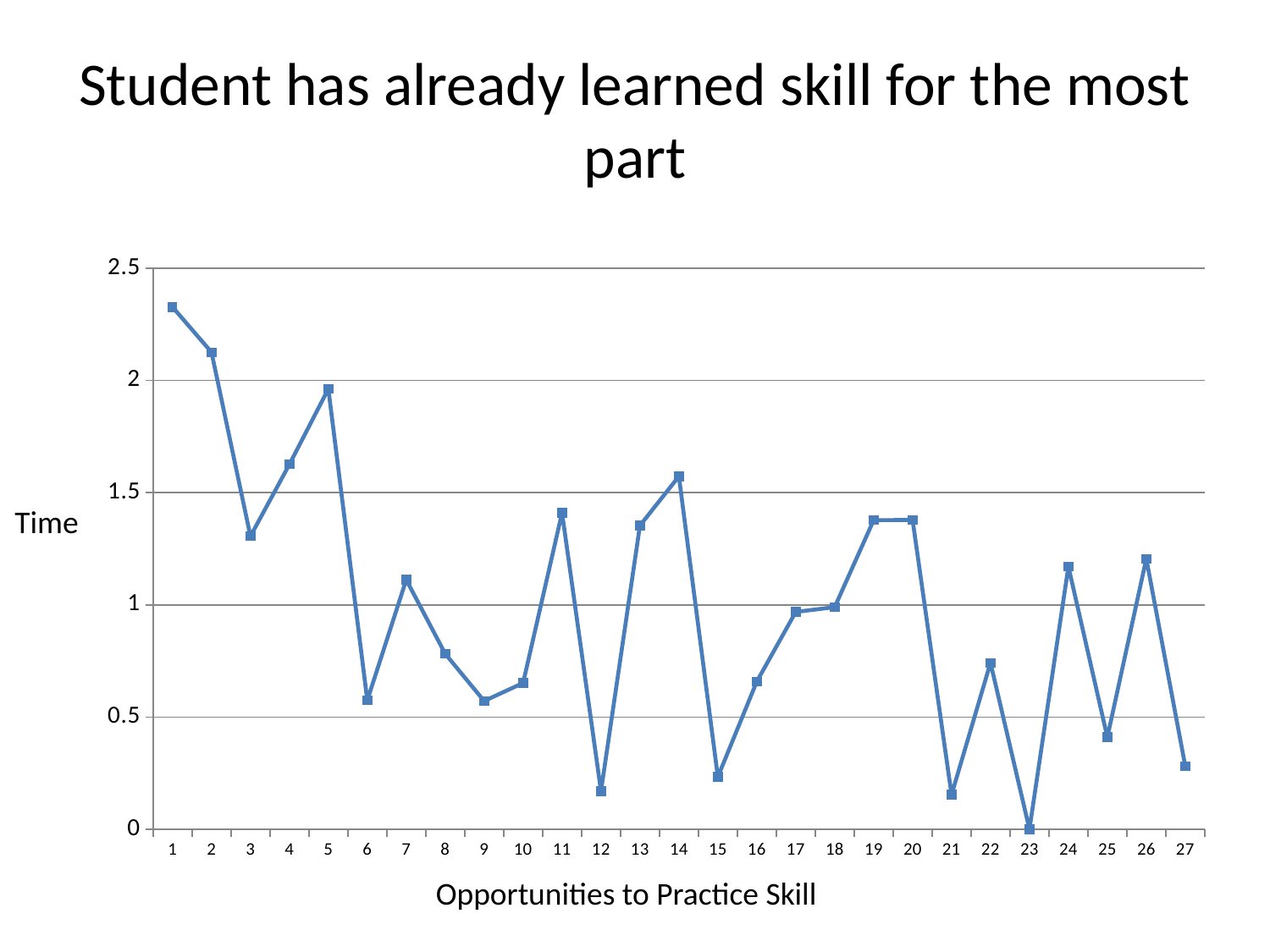
At which opportunity is the time lowest? 23 Is the time at opportunity 12 greater or less than 0.5? less Overall, does the time rise or fall as the number of opportunities to practice the skill increases? fall Is the time at opportunity 1 greater or less than 2? greater How many opportunities (points) are plotted along the x axis? 27 What is the label on the x axis of the chart? Opportunities to Practice Skill At which opportunity is the time highest? 1 Is the time at opportunity 14 greater or less than 1.5? greater What is the time value at opportunity 23? 0 What kind of chart is shown on the slide? line chart Which has a larger time value, opportunity 11 or opportunity 12? opportunity 11